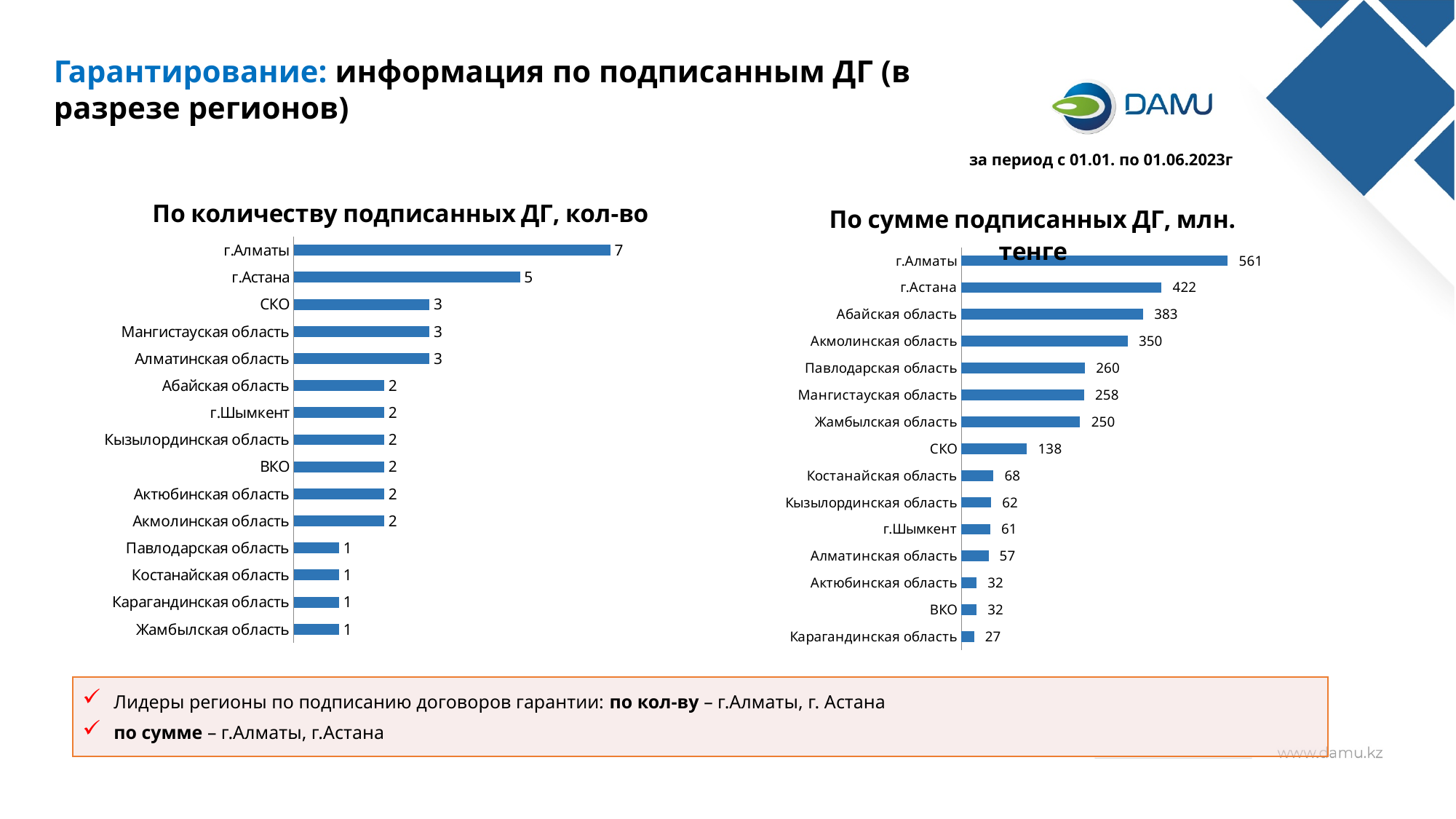
In the chart 'По сумме подписанных ДГ, млн. тенге', which is larger: Павлодарская область or Жамбылская область? Павлодарская область In the chart 'По количеству подписанных ДГ, кол-во', which region has the highest value? г.Алматы In the chart 'По сумме подписанных ДГ, млн. тенге', what is the value for СКО? 138 In the chart 'По количеству подписанных ДГ, кол-во', what is the value for г.Астана? 5 In the chart 'По количеству подписанных ДГ, кол-во', how many regions are listed? 15 In the chart 'По количеству подписанных ДГ, кол-во', what is the difference between г.Алматы and г.Астана? 2 In the chart 'По сумме подписанных ДГ, млн. тенге', what is the difference between г.Алматы and г.Астана? 139 In the chart 'По сумме подписанных ДГ, млн. тенге', which region has the highest value? г.Алматы In the chart 'По сумме подписанных ДГ, млн. тенге', which region has the lowest value? Карагандинская область In the chart 'По сумме подписанных ДГ, млн. тенге', what is the value for Акмолинская область? 350 In the chart 'По количеству подписанных ДГ, кол-во', what is the value for Абайская область? 2 What type of chart is 'По сумме подписанных ДГ, млн. тенге'? Bar chart